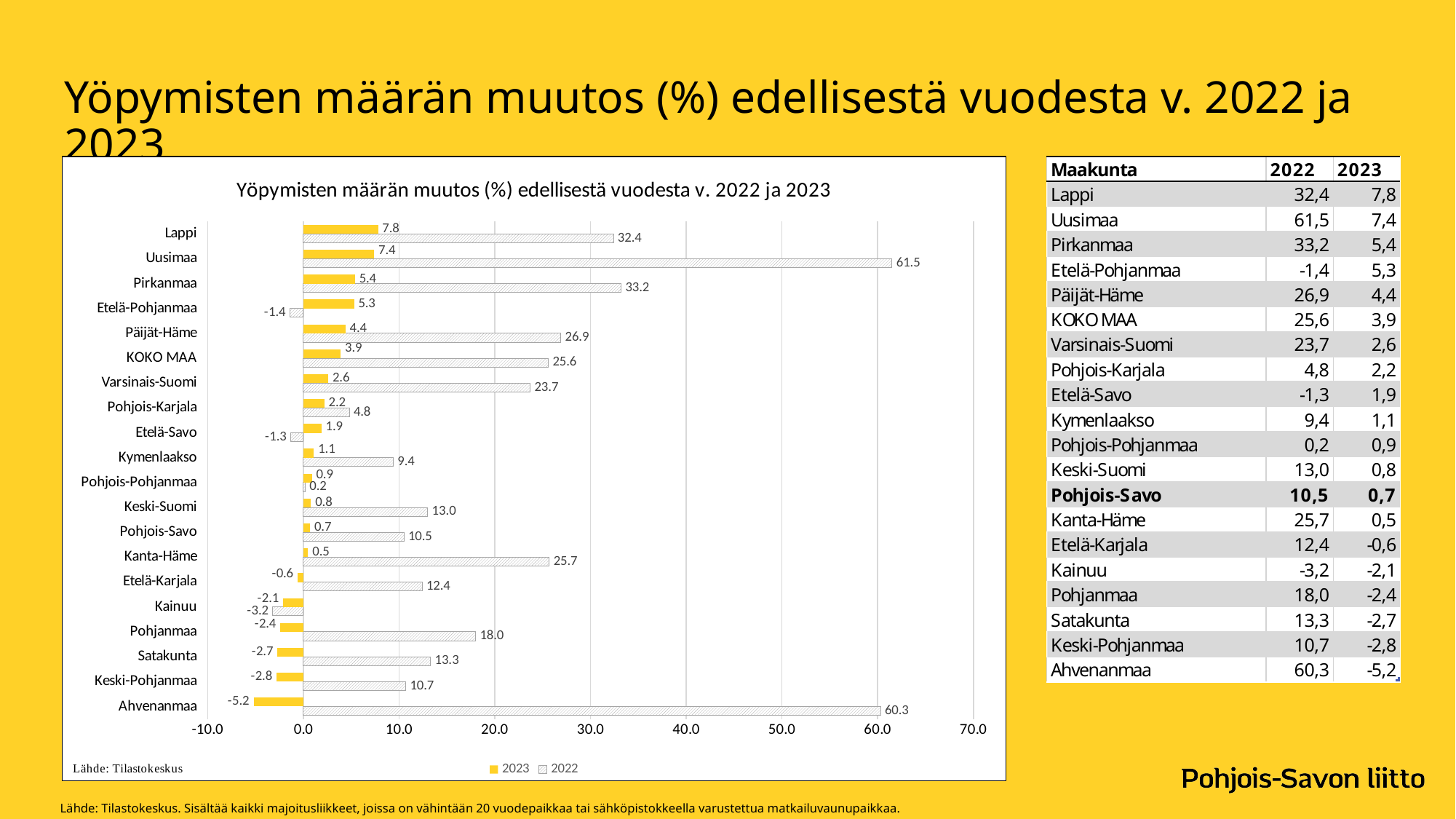
What kind of chart is shown on the slide? Bar chart How many regions (categories) are plotted in the chart? 20 What is the 2022 value for Uusimaa in the chart? 61.5 Which is larger in the chart: the 2022 value for Pirkanmaa or the 2022 value for Lappi? Pirkanmaa Which region has the highest 2023 value in the chart? Lappi Which region has the lowest 2022 value in the chart? Kainuu Which series in the chart is drawn with solid yellow bars? 2023 What is the 2022 value for Etelä-Pohjanmaa in the chart? -1.4 Which region has the lowest 2023 value in the chart? Ahvenanmaa What is the 2023 value for Pohjois-Savo in the chart? 0.7 What is the difference between the 2022 and 2023 values for Ahvenanmaa in the chart? 65.5 How many series does the chart legend list? 2